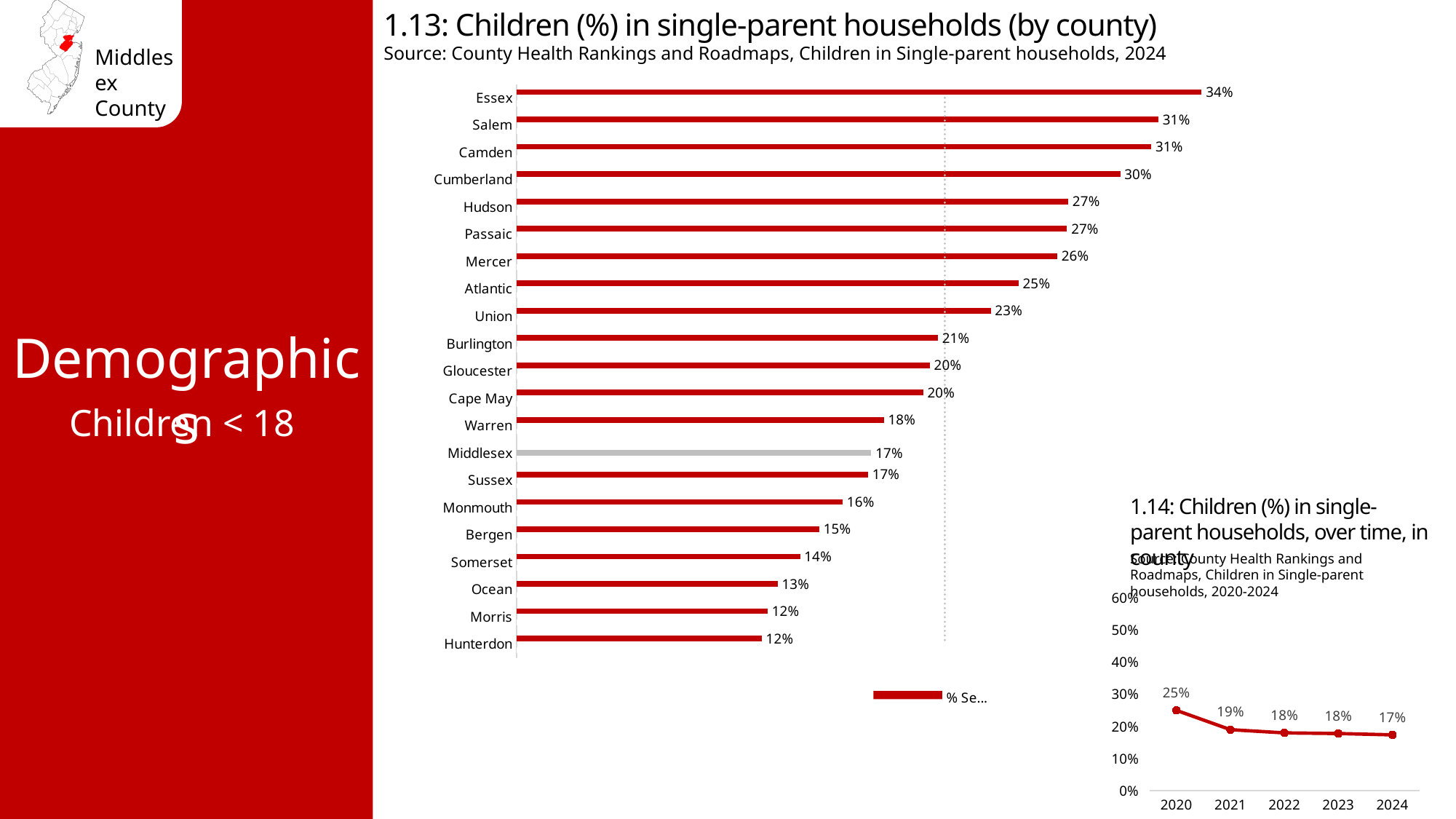
In chart 1.14, do the values rise or fall from 2020 to 2024? Fall In chart 1.13 (Children (%) in single-parent households by county), what is the value for Middlesex? 17% In chart 1.14, how many years are plotted? 5 In chart 1.13, which is larger, the value for Union or the value for Burlington? Union In chart 1.14 (Children (%) in single-parent households over time), what is the value for 2020? 25% In chart 1.13, which county has the highest percentage of children in single-parent households? Essex In chart 1.13, how many counties are shown? 21 What kind of chart is chart 1.13? Bar chart In chart 1.13, what is the value for Cumberland? 30% In chart 1.13, what is the difference between the values for Essex and Middlesex? 17 percentage points In chart 1.13, what is the value for Hudson? 27% In chart 1.14, what is the difference between the values for 2020 and 2024? 8 percentage points